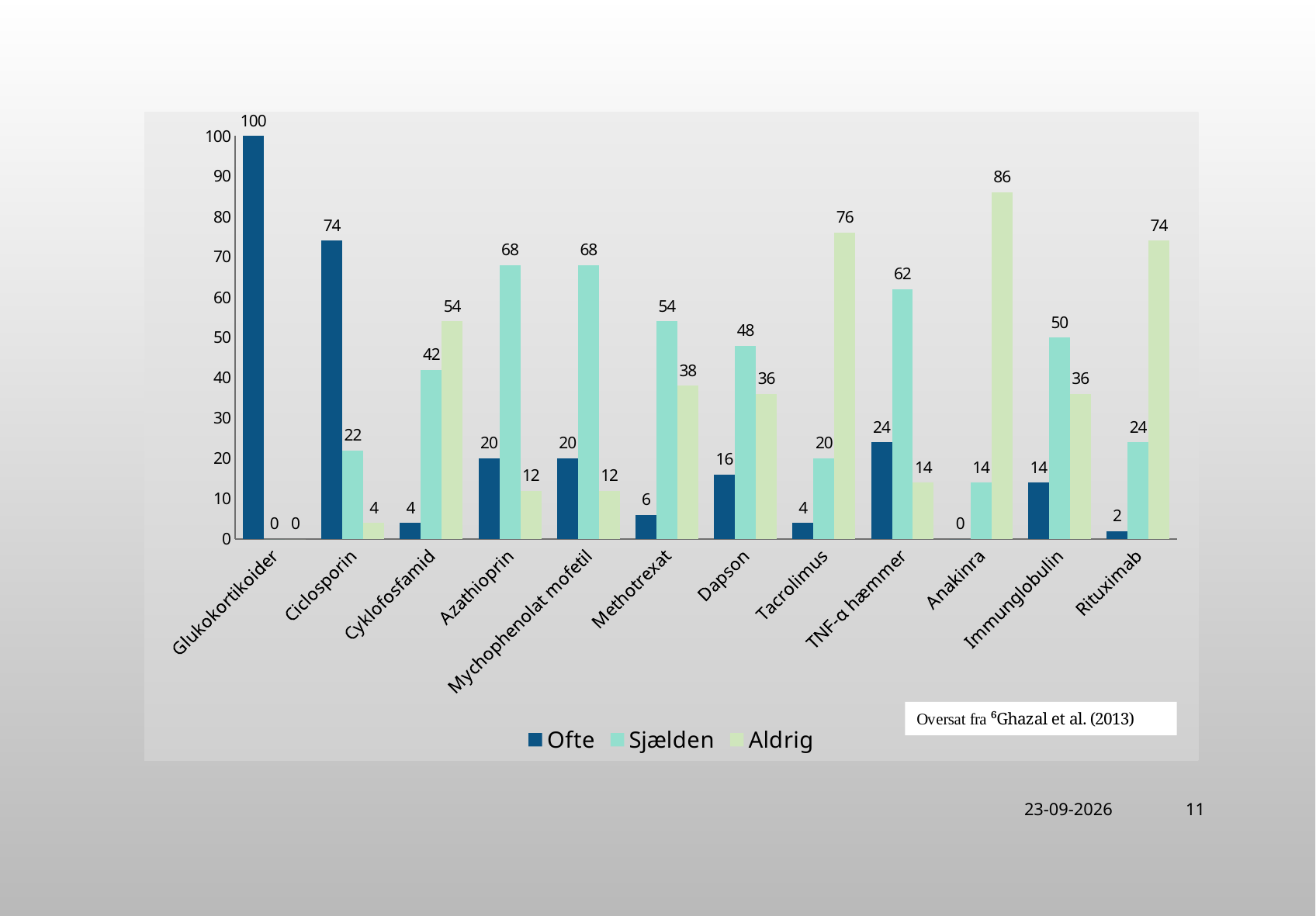
What is the value for Aldrig for Anakinra? 86 What kind of chart is shown on the slide? Bar chart What is the total of the three values for Dapson? 100 Is the Sjælden value for Azathioprin greater or less than 60? greater How many categories are shown on the x axis? 12 What is the value for Sjælden for TNF-α hæmmer? 62 Which is larger for Methotrexat: the Sjælden value or the Aldrig value? Sjælden What is the value for Ofte for Ciclosporin? 74 How many series does the legend list? 3 Which category has the lowest Aldrig value? Glukokortikoider Which category has the highest Ofte value? Glukokortikoider What is the difference between the Aldrig value for Tacrolimus and the Aldrig value for Rituximab? 2